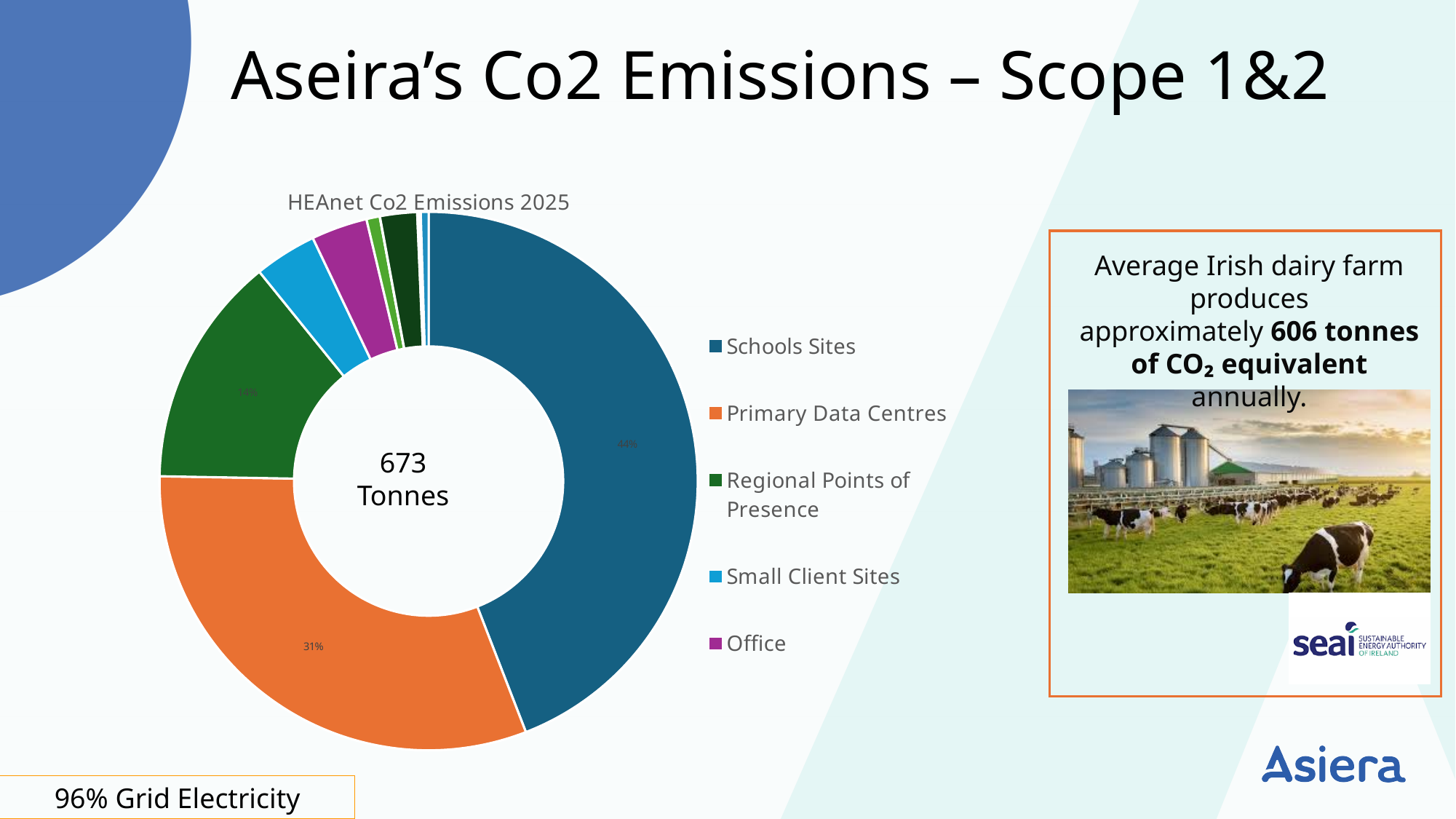
What is the title of the doughnut chart? HEAnet Co2 Emissions 2025 What kind of chart is used to show HEAnet Co2 Emissions 2025? Doughnut (pie) chart Which category has the largest share in the HEAnet Co2 Emissions 2025 chart? Schools Sites What total value is shown in the centre of the doughnut chart? 673 Tonnes Is the share for Schools Sites greater or less than 40%? greater What percentage of the HEAnet Co2 Emissions 2025 chart is attributed to Schools Sites? 44% Which has a larger share of emissions, Primary Data Centres or Regional Points of Presence? Primary Data Centres What is the difference in percentage points between the Schools Sites share and the Primary Data Centres share? 13 percentage points What percentage of the HEAnet Co2 Emissions 2025 chart is attributed to Regional Points of Presence? 14% What colour represents Office in the doughnut chart? Purple What percentage of the HEAnet Co2 Emissions 2025 chart is attributed to Primary Data Centres? 31% How many categories does the legend of the HEAnet Co2 Emissions 2025 chart list? 5